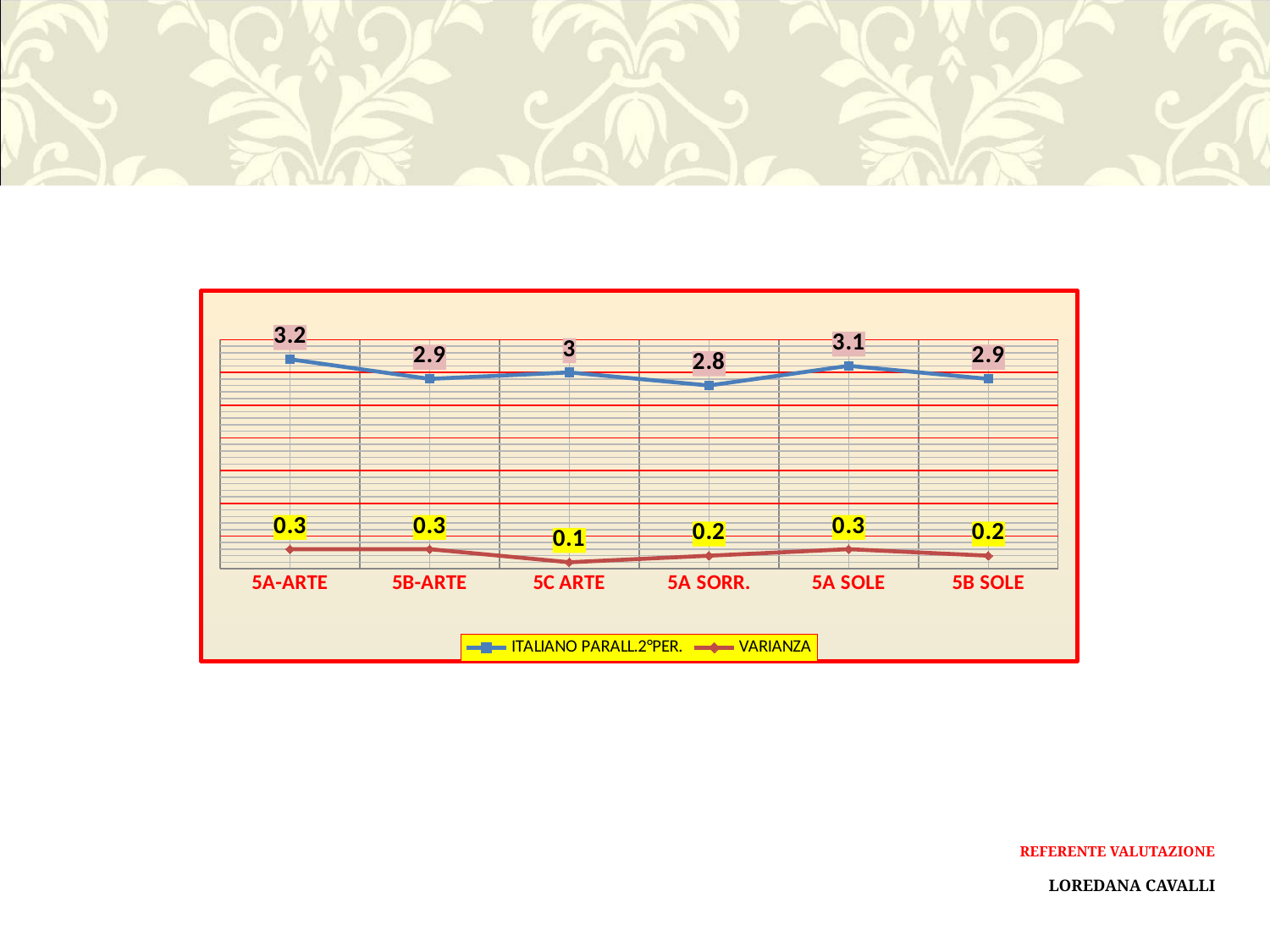
How many categories are shown on the x axis? 6 Which category has the highest ITALIANO PARALL.2°PER. value? 5A-ARTE Which category has the lowest VARIANZA value? 5C ARTE What kind of chart is shown on the slide? line chart Which is larger, the ITALIANO PARALL.2°PER. value for 5A SOLE or for 5B SOLE? 5A SOLE Which category has the lowest ITALIANO PARALL.2°PER. value? 5A SORR. What is the ITALIANO PARALL.2°PER. value for 5A-ARTE? 3.2 What is the ITALIANO PARALL.2°PER. value for 5A SORR.? 2.8 What is the VARIANZA value for 5C ARTE? 0.1 How many series does the legend list? 2 What colour is the VARIANZA line? red What is the difference between the ITALIANO PARALL.2°PER. values for 5A-ARTE and 5A SORR.? 0.4